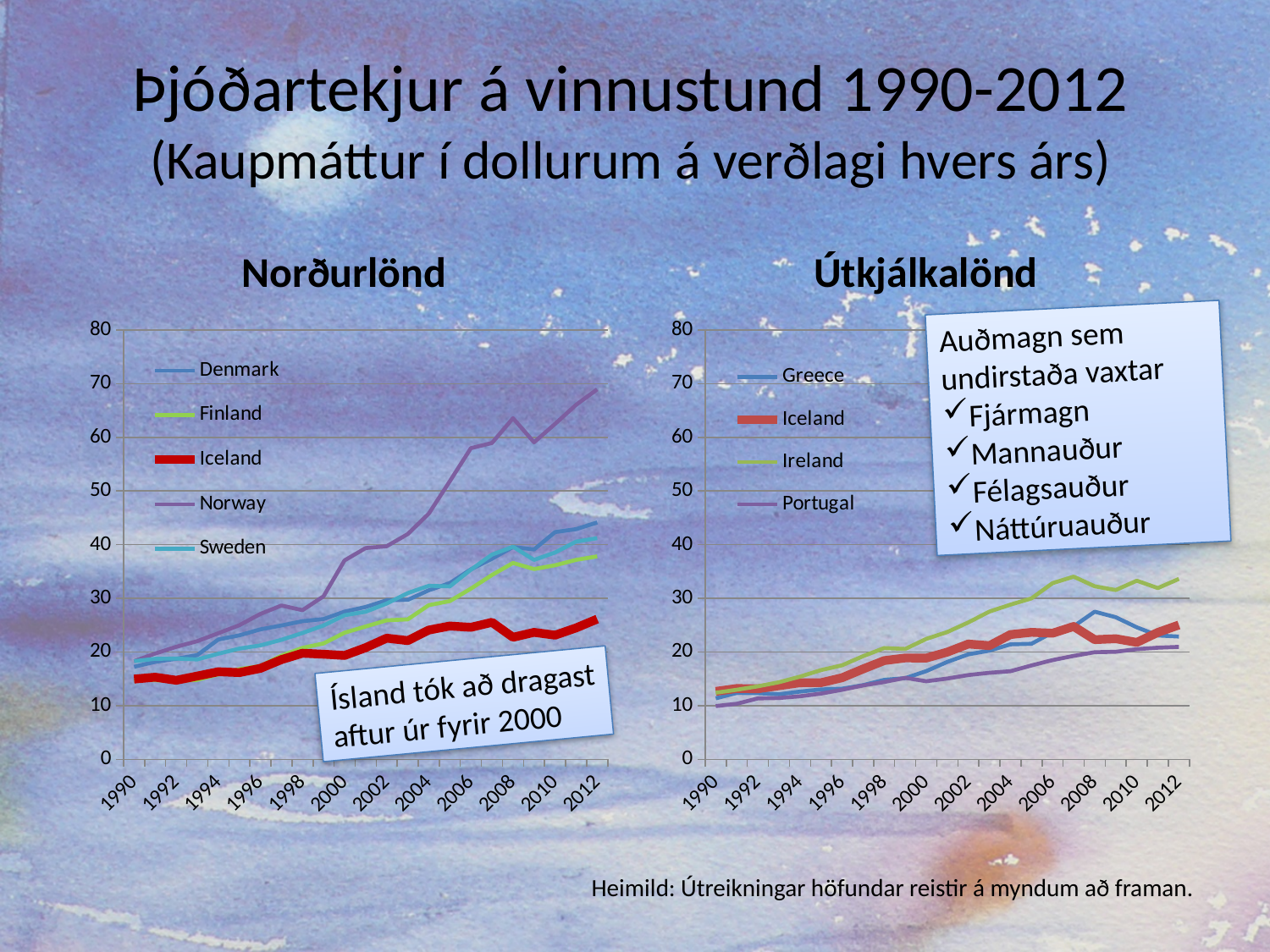
In the Norðurlönd chart, is the value for Norway in 2012 greater or less than 60? greater In the Útkjálkalönd chart, is the value for Portugal in 2012 greater or less than 30? less How many series does the legend of the Norðurlönd chart list? 5 In the Norðurlönd chart, is the value for Iceland in 2012 greater or less than 30? less In the Norðurlönd chart, which country has the highest value in 2012? Norway How many series does the legend of the Útkjálkalönd chart list? 4 In the Útkjálkalönd chart, which country has the highest value in 2012? Ireland In the Norðurlönd chart, does the Norway line rise or fall overall from 1990 to 2012? rise Which country appears in the legends of both charts? Iceland What kind of chart is the Norðurlönd chart on the left? line chart In the Norðurlönd chart, which country has the lowest value in 2012? Iceland